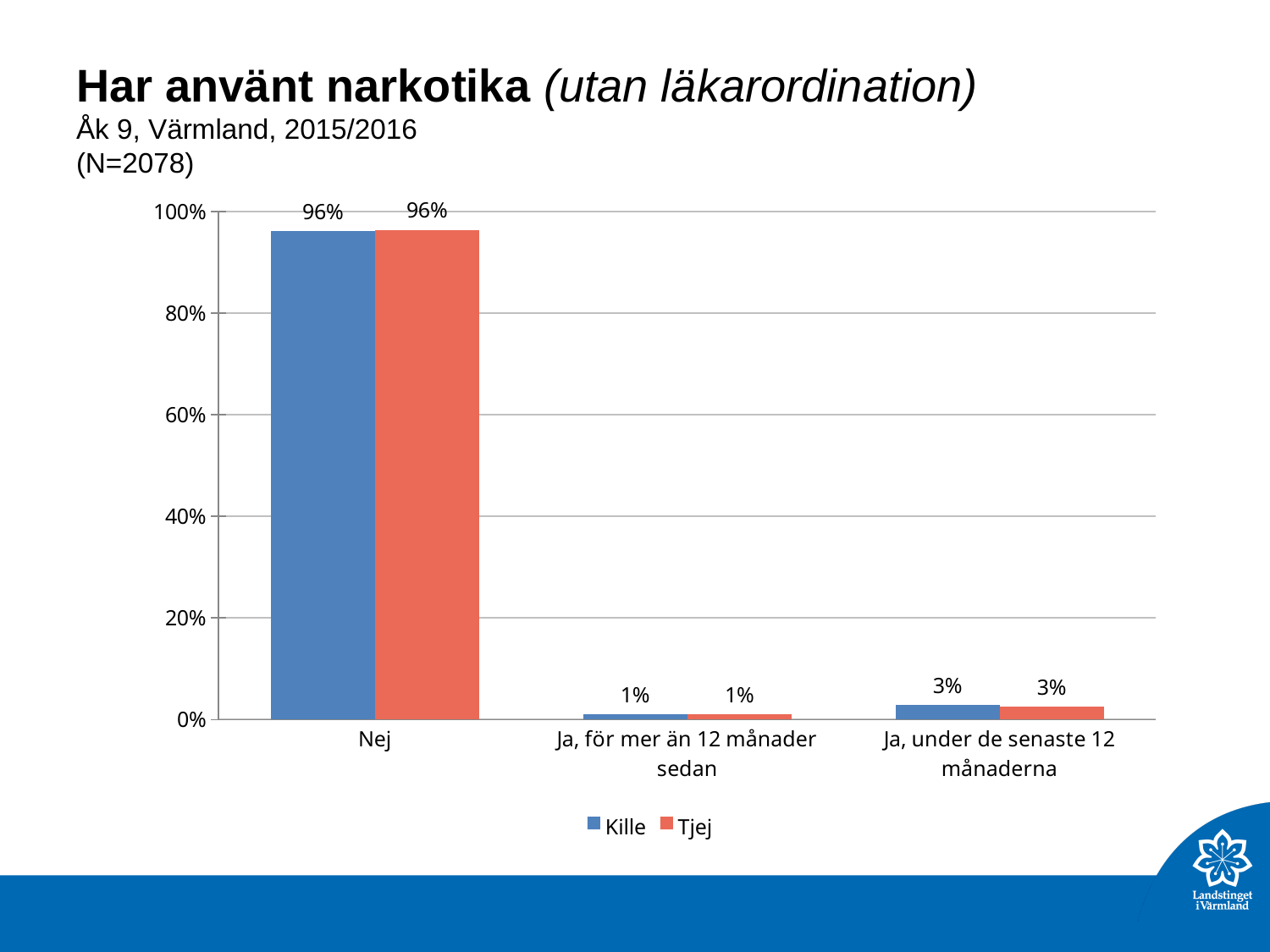
What is the value for Tjej in the 'Ja, under de senaste 12 månaderna' category? 3% What kind of chart is shown on the slide? bar chart Is the value for Kille in the Nej category greater or less than 80%? greater What is the value for Kille in the 'Ja, för mer än 12 månader sedan' category? 1% What is the value for Kille in the Nej category? 96% Which is larger for Tjej: 'Ja, under de senaste 12 månaderna' or 'Ja, för mer än 12 månader sedan'? Ja, under de senaste 12 månaderna How many categories are shown on the x axis? 3 Which category has the lowest value for Kille? Ja, för mer än 12 månader sedan Which category has the highest value for Tjej? Nej What are the two series named in the legend? Kille and Tjej How many series does the legend list? 2 What is the difference between the Kille value for Nej and the Kille value for 'Ja, under de senaste 12 månaderna'? 93 percentage points